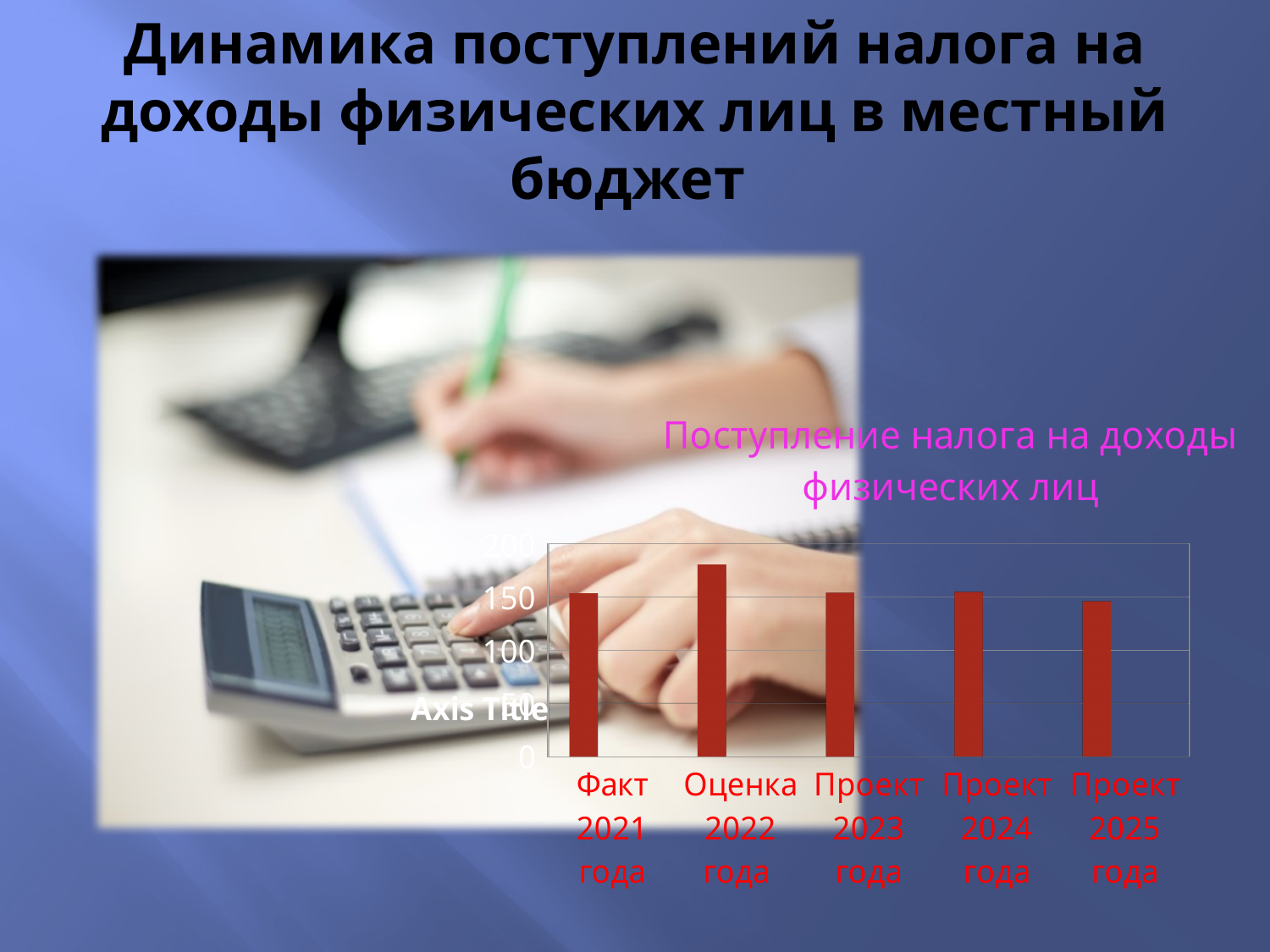
Which is larger, the value for Оценка 2022 года or the value for Проект 2023 года? Оценка 2022 года Is the value for Оценка 2022 года greater or less than 150? greater Is the value for Факт 2021 года greater or less than 200? less Which is larger, the value for Оценка 2022 года or the value for Проект 2025 года? Оценка 2022 года How many categories (bars) does the chart show? 5 What is the title of the chart? Поступление налога на доходы физических лиц Is the value for Оценка 2022 года greater or less than 200? less What is the highest tick value shown on the vertical axis of the chart? 200 Which category has the highest bar in the chart? Оценка 2022 года What kind of chart is shown on the slide? bar chart